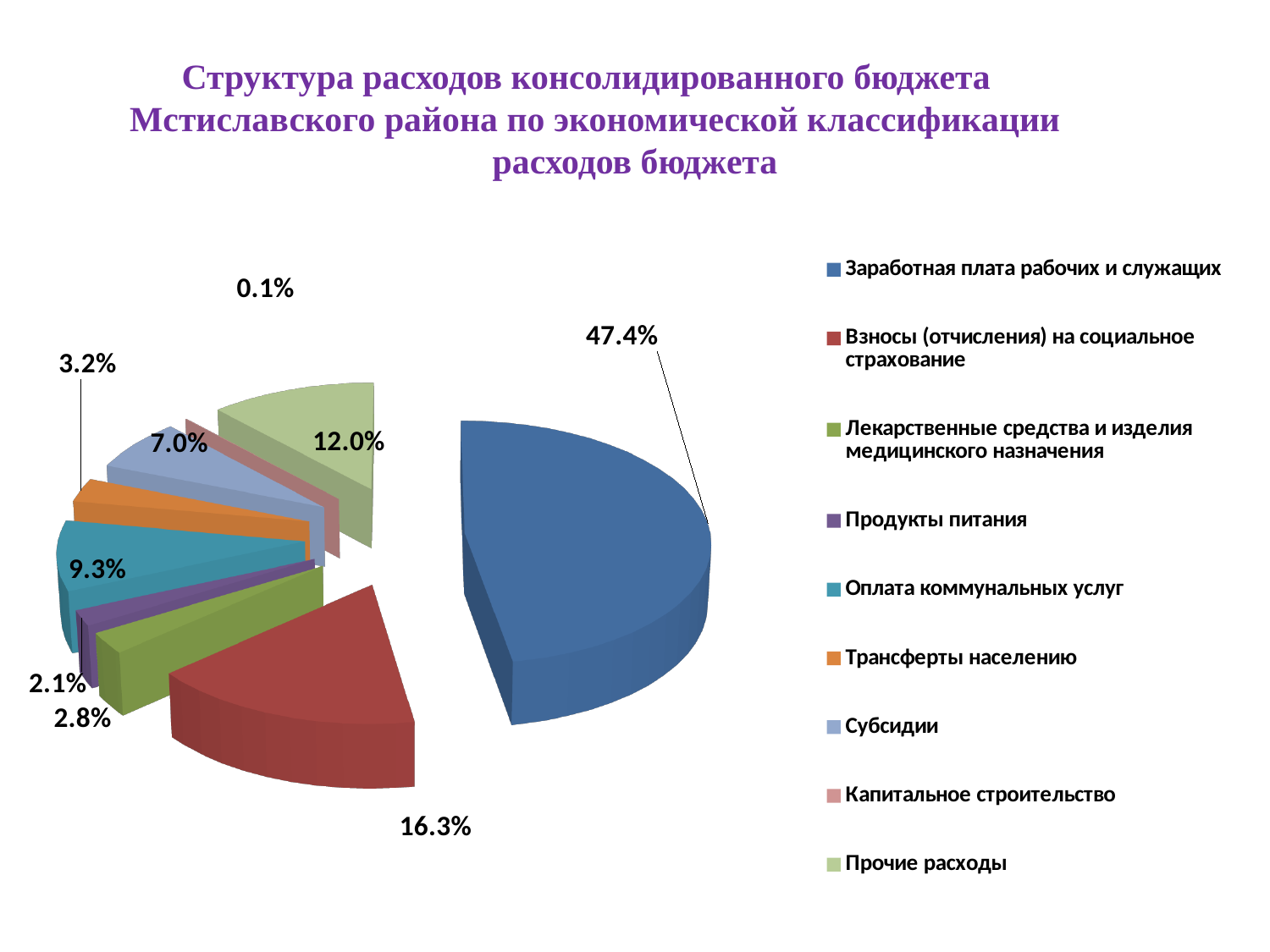
What is the difference in percentage points between Заработная плата рабочих и служащих and Взносы (отчисления) на социальное страхование? 31.1 Which category has the largest share of the pie? Заработная плата рабочих и служащих What colour is the slice for Трансферты населению? orange How many categories does the legend list? 9 What share of expenditures is for Прочие расходы? 12.0% What share of expenditures is for Взносы (отчисления) на социальное страхование? 16.3% Which is larger: the share for Прочие расходы or the share for Оплата коммунальных услуг? Прочие расходы What share of expenditures is for Оплата коммунальных услуг? 9.3% What kind of chart is shown on the slide? pie chart What share of expenditures is for Заработная плата рабочих и служащих? 47.4% What share of expenditures is for Субсидии? 7.0% Which category has the smallest share of the pie? Капитальное строительство